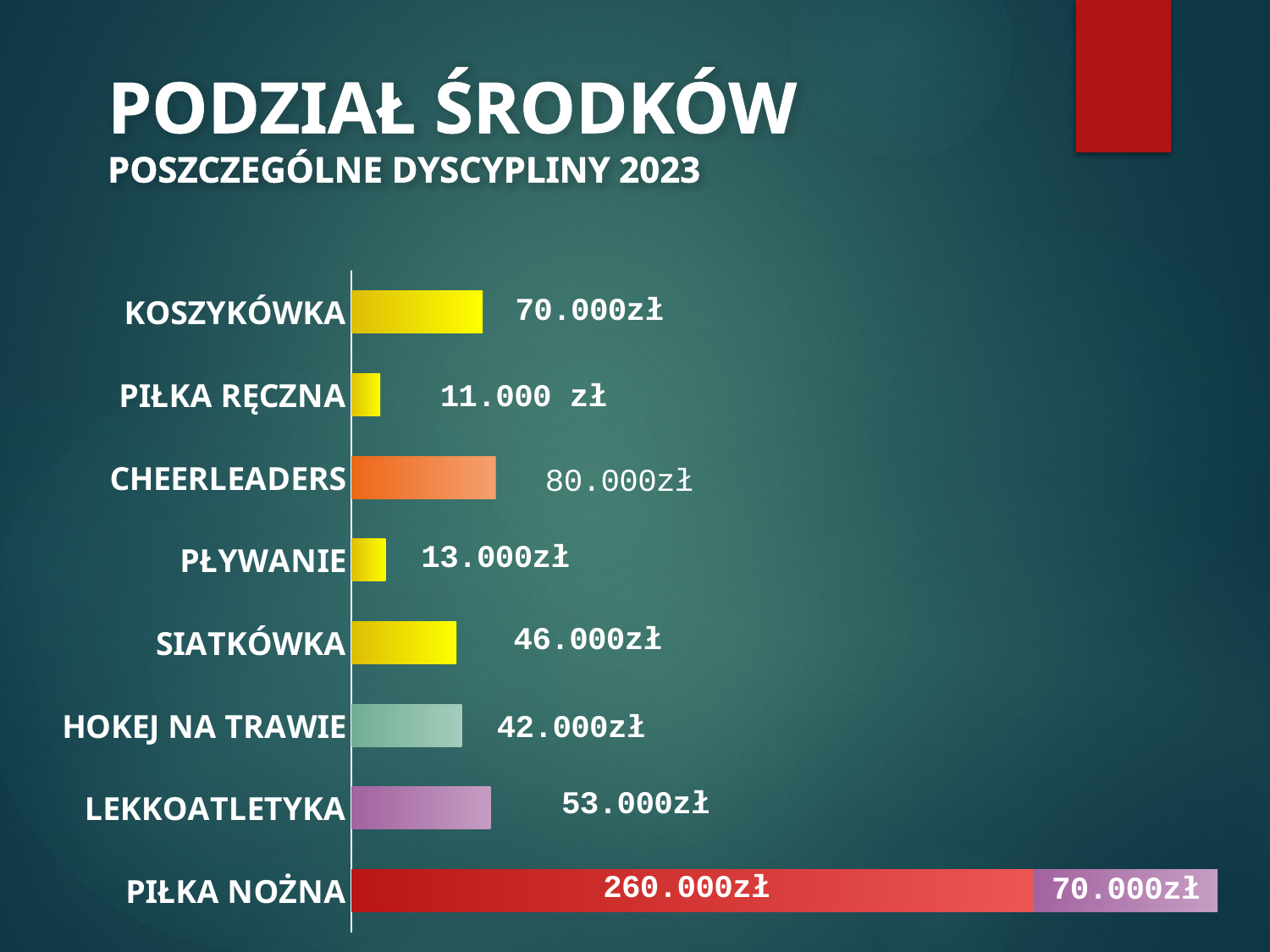
What value is shown for HOKEJ NA TRAWIE? 42.000zł Which discipline has the highest value? PIŁKA NOŻNA What kind of chart is shown on the slide? bar chart What is the value of the red segment of the PIŁKA NOŻNA bar? 260.000zł Which is larger, the value for CHEERLEADERS or for LEKKOATLETYKA? CHEERLEADERS Which discipline has the lowest value? PIŁKA RĘCZNA What value is shown for KOSZYKÓWKA? 70.000zł What is the difference between the values for KOSZYKÓWKA and SIATKÓWKA? 24.000zł How many disciplines are shown in the chart? 8 What is the total of the two segments of the PIŁKA NOŻNA bar? 330.000zł What value is shown for PIŁKA RĘCZNA? 11.000 zł What value is shown for CHEERLEADERS? 80.000zł